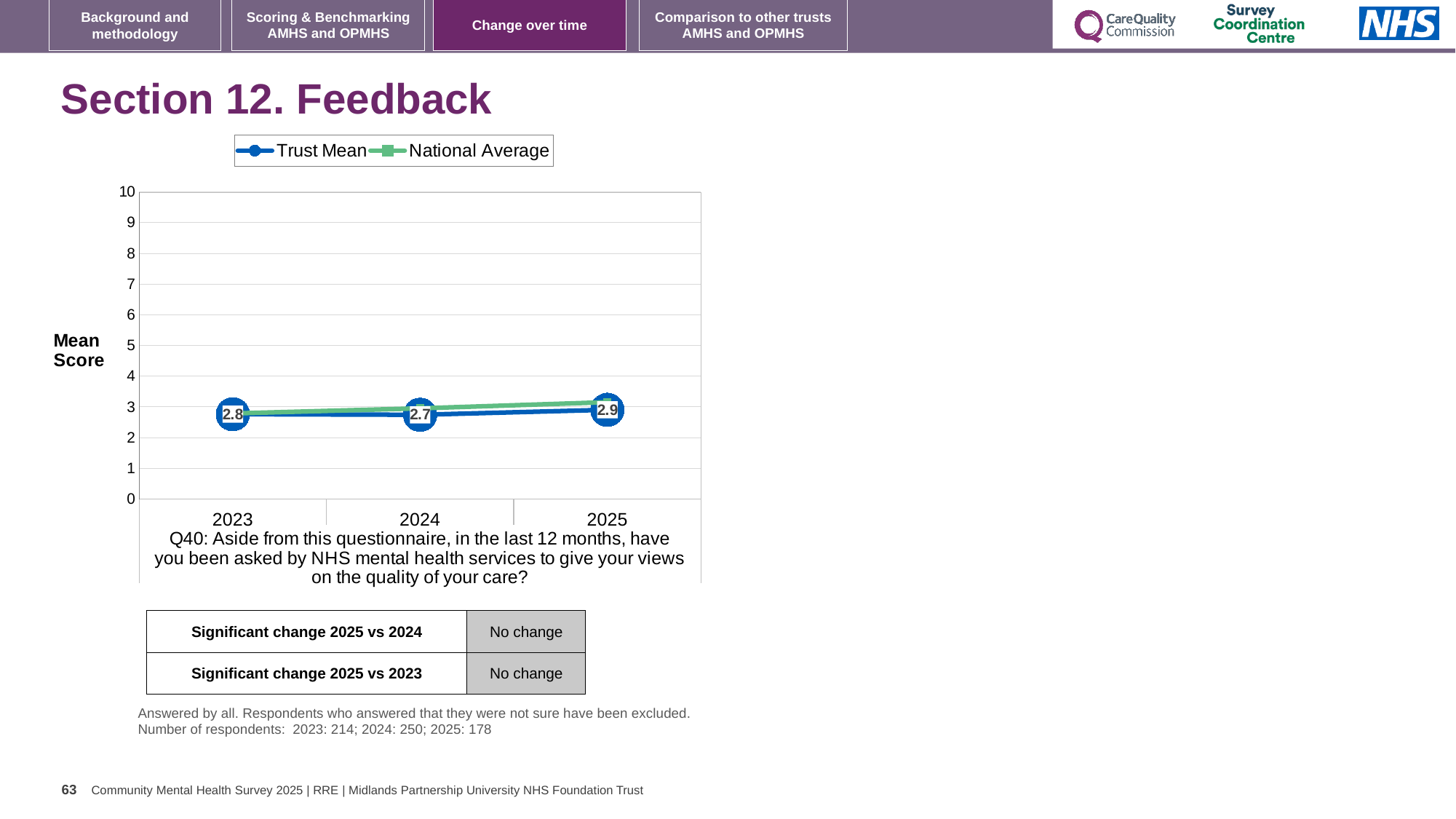
How many years are plotted on the x axis? 3 What kind of chart is shown on the slide? Line chart How many series does the legend list? 2 What is the Trust Mean score for 2023? 2.8 What is the difference between the Trust Mean scores for 2025 and 2024? 0.2 In which year is the Trust Mean score highest? 2025 Is the Trust Mean score for 2025 greater or less than 5? less What is the Trust Mean score for 2025? 2.9 In which year is the Trust Mean score lowest? 2024 Which year has the larger Trust Mean score, 2023 or 2024? 2023 Does the Trust Mean score rise or fall from 2024 to 2025? Rise What is the Trust Mean score for 2024? 2.7